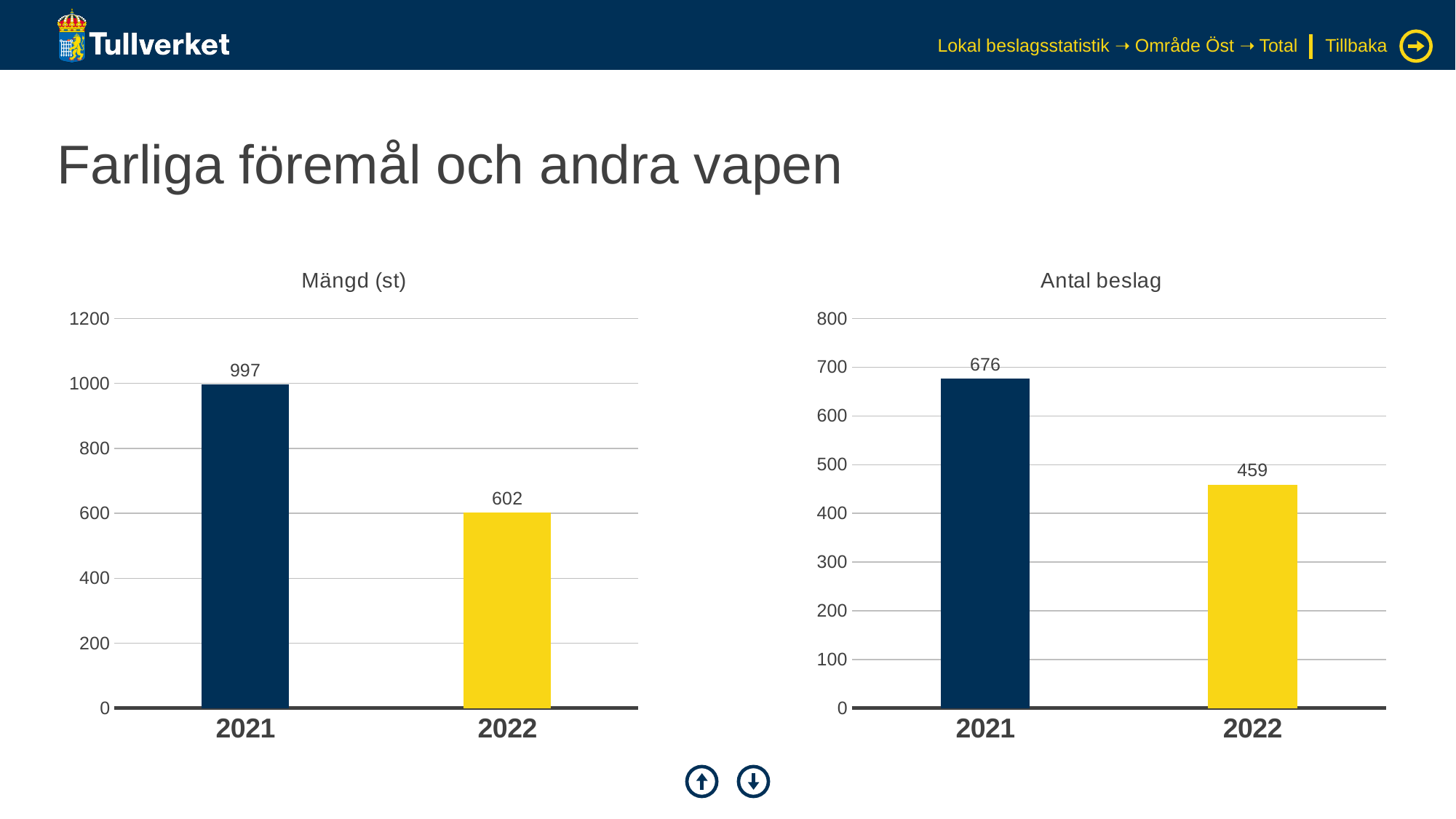
In the "Antal beslag" chart, what is the value for 2022? 459 In the "Mängd (st)" chart, which year has the highest value? 2021 In the "Antal beslag" chart, which year has the lowest value? 2022 In the "Antal beslag" chart, what is the value for 2021? 676 In the "Antal beslag" chart, do the values rise or fall from 2021 to 2022? fall What kind of chart is the "Antal beslag" chart? bar chart In the "Mängd (st)" chart, what is the difference between the 2021 and 2022 values? 395 In the "Antal beslag" chart, is the value for 2021 greater or less than 600? greater How many bars are shown in the "Mängd (st)" chart? 2 In the "Mängd (st)" chart, what is the value for 2021? 997 In the "Antal beslag" chart, what is the difference between the 2021 and 2022 values? 217 In the "Mängd (st)" chart, what is the value for 2022? 602